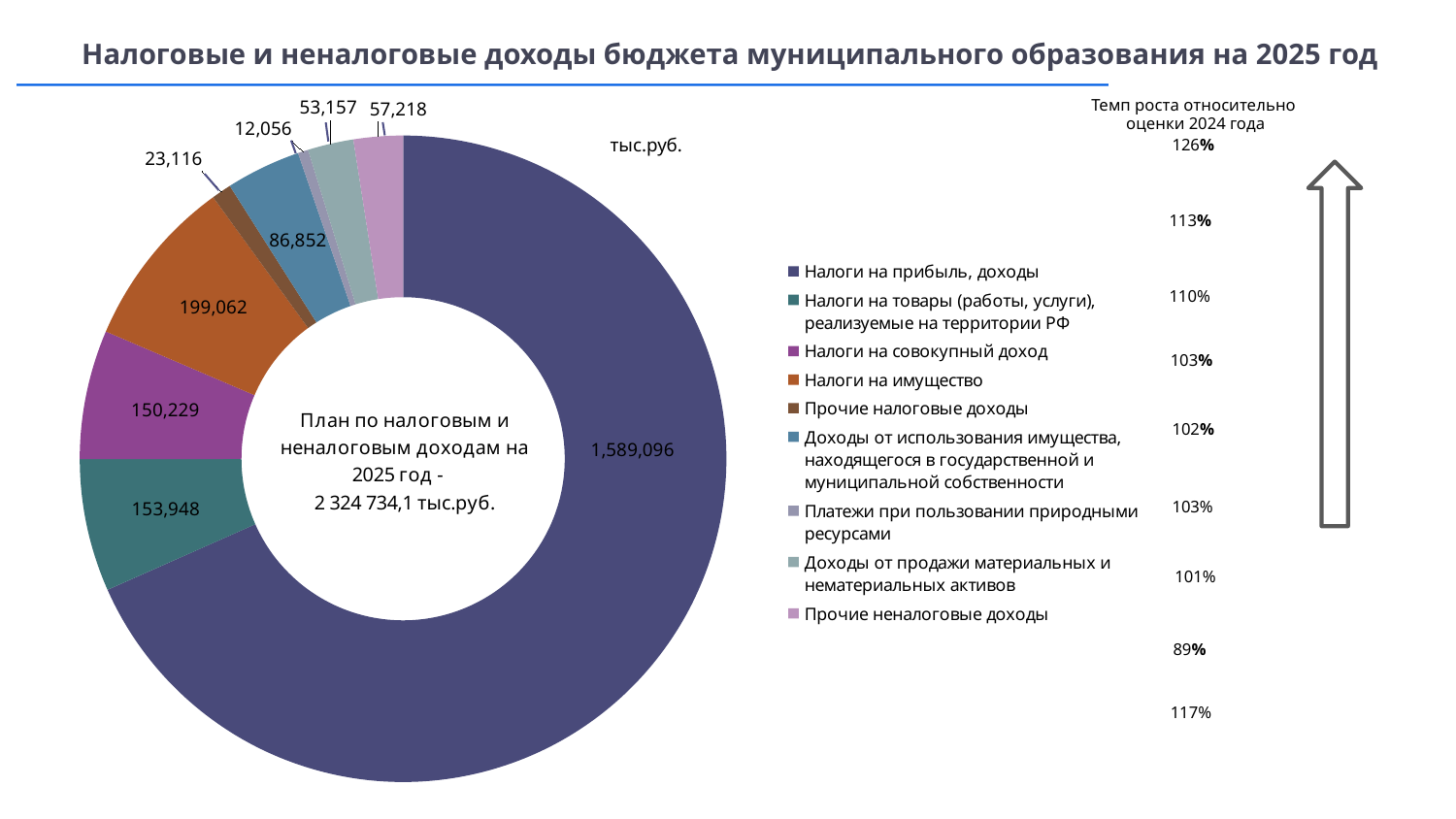
What kind of chart is shown on the slide? Doughnut (pie) chart What is the difference between Налоги на имущество and Налоги на товары (работы, услуги), реализуемые на территории РФ? 45,114 What is the value for Налоги на прибыль, доходы? 1,589,096 What is the value for Доходы от использования имущества, находящегося в государственной и муниципальной собственности? 86,852 Which is larger: Налоги на товары (работы, услуги), реализуемые на территории РФ or Налоги на совокупный доход? Налоги на товары (работы, услуги), реализуемые на территории РФ What is the value for Налоги на имущество? 199,062 What is the value for Прочие неналоговые доходы? 57,218 What is the difference between Прочие неналоговые доходы and Доходы от продажи материальных и нематериальных активов? 4,061 Which category has the smallest slice? Платежи при пользовании природными ресурсами Which category has the largest slice? Налоги на прибыль, доходы How many categories does the chart show? 9 What total is stated in the centre of the chart for the 2025 plan? 2 324 734,1 тыс.руб.